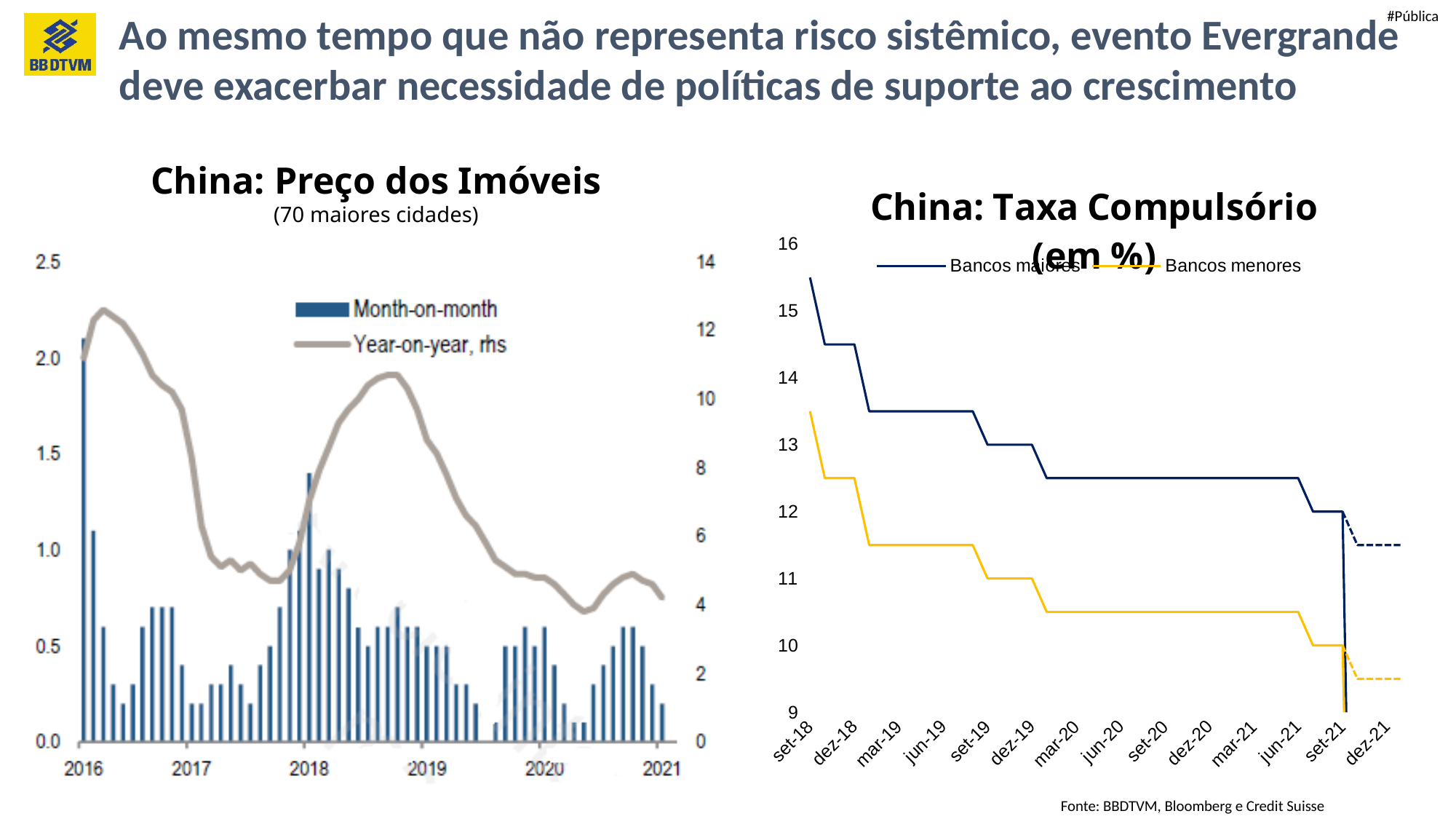
In the 'China: Preço dos Imóveis' chart, is the Year-on-year value at the start of 2016 greater or less than 10 on the right-hand axis? greater In the 'China: Taxa Compulsório (em %)' chart, do the values for Bancos maiores rise or fall from set-18 to dez-21? fall In the 'China: Taxa Compulsório (em %)' chart, is the value for Bancos maiores at mar-20 greater or less than 12? greater In the 'China: Taxa Compulsório (em %)' chart, is the value for Bancos menores at dez-21 greater or less than 10? less In the 'China: Preço dos Imóveis' chart, which series is plotted as bars? Month-on-month How many series does the legend of the 'China: Preço dos Imóveis' chart list? 2 How many series does the legend of the 'China: Taxa Compulsório (em %)' chart list? 2 In the 'China: Taxa Compulsório (em %)' chart, which series has the higher value at set-18, Bancos maiores or Bancos menores? Bancos maiores What kind of chart is the 'China: Taxa Compulsório (em %)' chart on the right? line chart